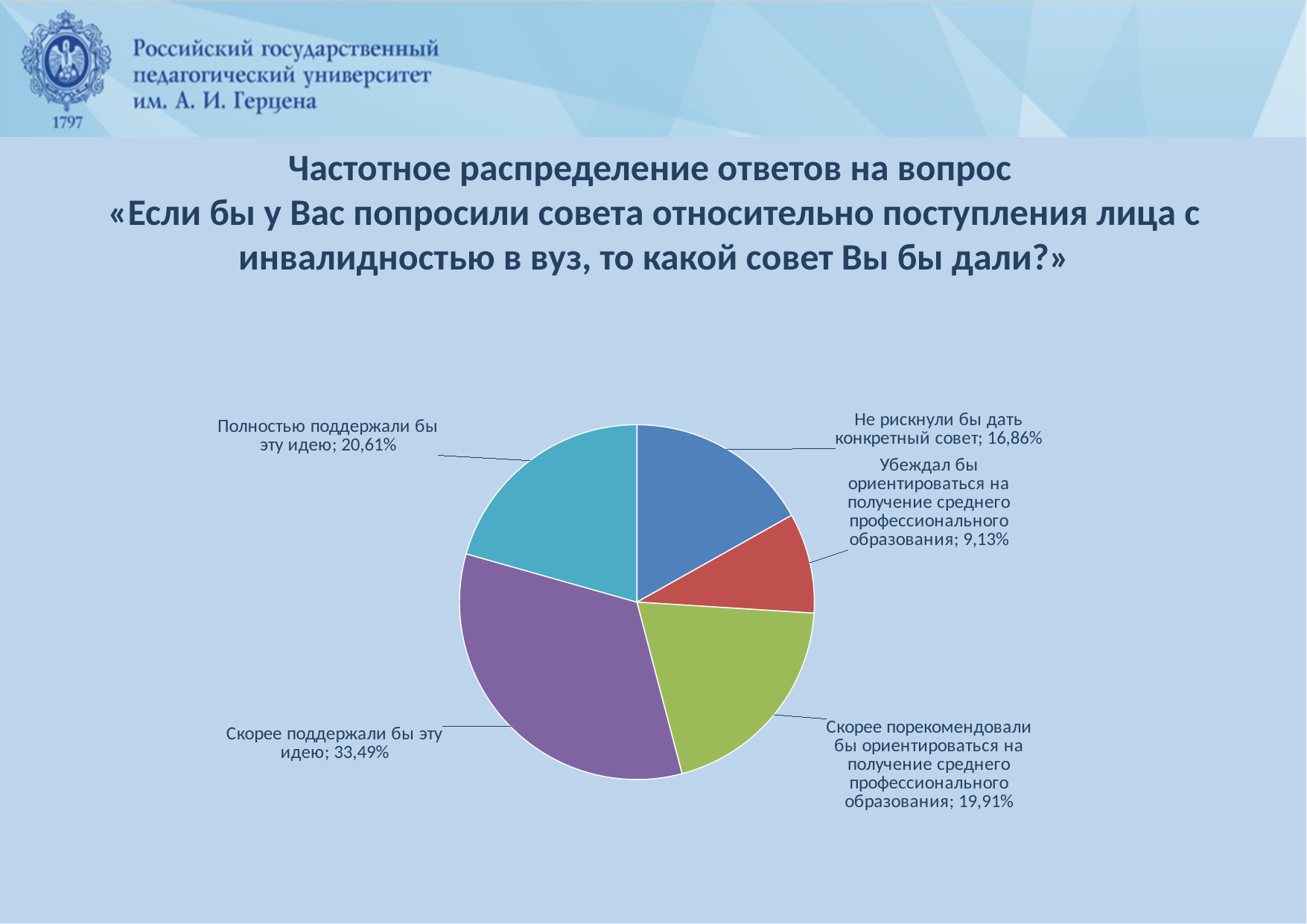
What share of respondents answered «Полностью поддержали бы эту идею»? 20,61% What share of respondents answered «Убеждал бы ориентироваться на получение среднего профессионального образования»? 9,13% Which is larger: the share for «Полностью поддержали бы эту идею» or for «Скорее порекомендовали бы ориентироваться на получение среднего профессионального образования»? Полностью поддержали бы эту идею What share of respondents answered «Не рискнули бы дать конкретный совет»? 16,86% How many slices does the pie chart have? 5 What share of respondents answered «Скорее поддержали бы эту идею»? 33,49% What is the difference between the shares for «Скорее поддержали бы эту идею» and «Полностью поддержали бы эту идею»? 12,88% Which answer has the smallest share of the pie? Убеждал бы ориентироваться на получение среднего профессионального образования What is the difference between the shares for «Не рискнули бы дать конкретный совет» and «Убеждал бы ориентироваться на получение среднего профессионального образования»? 7,73% What kind of chart is shown on the slide? Pie chart What colour is the slice for «Скорее поддержали бы эту идею»? Purple Which answer has the largest share of the pie? Скорее поддержали бы эту идею